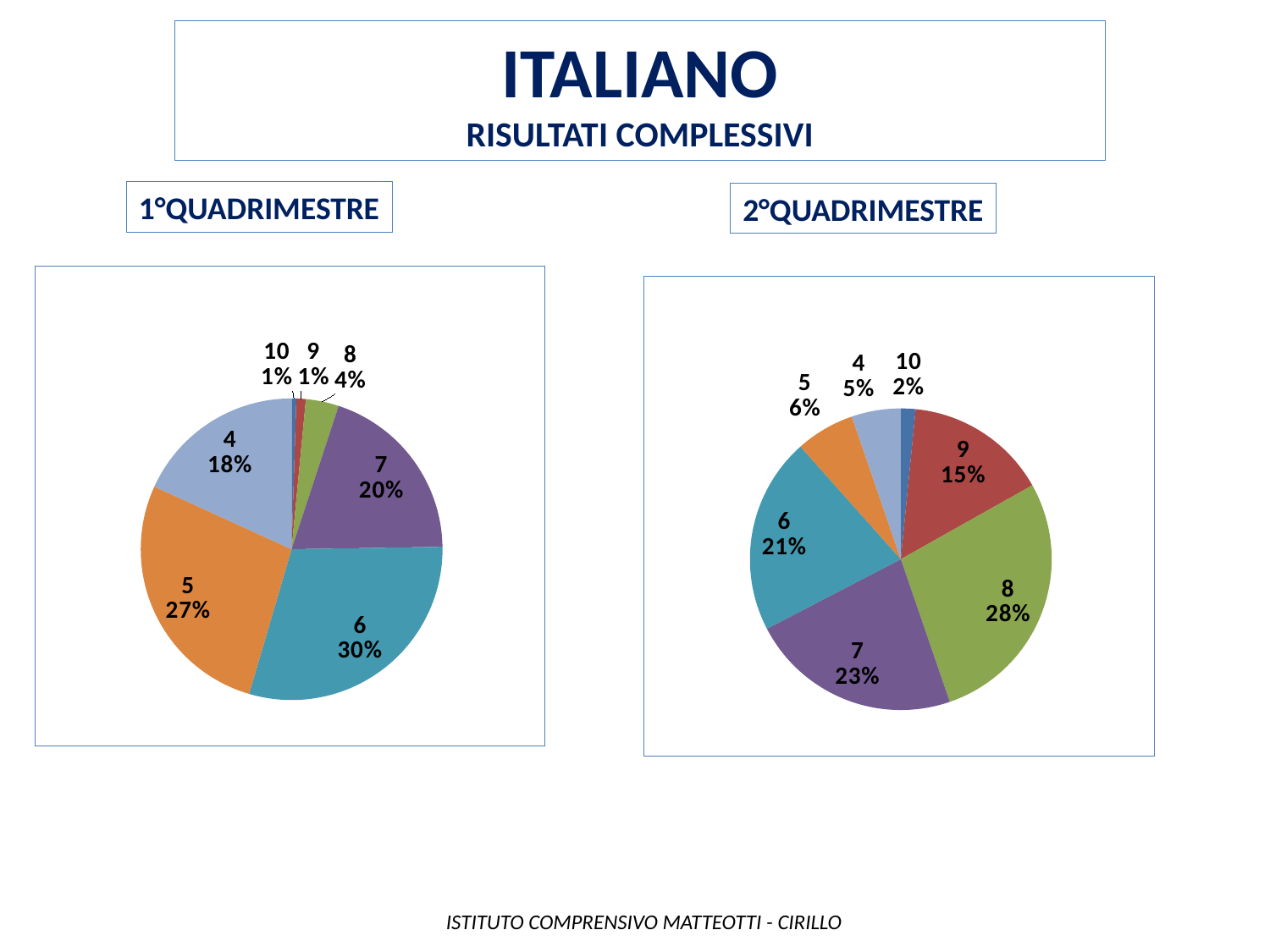
In the 1°QUADRIMESTRE pie chart, what share does grade 6 have? 30% In the 1°QUADRIMESTRE pie chart, which grade has the largest share? 6 In the 1°QUADRIMESTRE pie chart, how many slices are there? 7 What kind of chart is used for the 1°QUADRIMESTRE results? Pie chart In the 2°QUADRIMESTRE pie chart, which has a larger share, grade 6 or grade 7? 7 In the 2°QUADRIMESTRE pie chart, what share does grade 8 have? 28% In the 1°QUADRIMESTRE pie chart, what is the difference between the shares of grade 6 and grade 7? 10% In the 2°QUADRIMESTRE pie chart, which grade has the smallest share? 10 In the 1°QUADRIMESTRE pie chart, what share does grade 5 have? 27% In the 2°QUADRIMESTRE pie chart, what is the difference between the shares of grade 8 and grade 4? 23% In the 2°QUADRIMESTRE pie chart, which grade has the largest share? 8